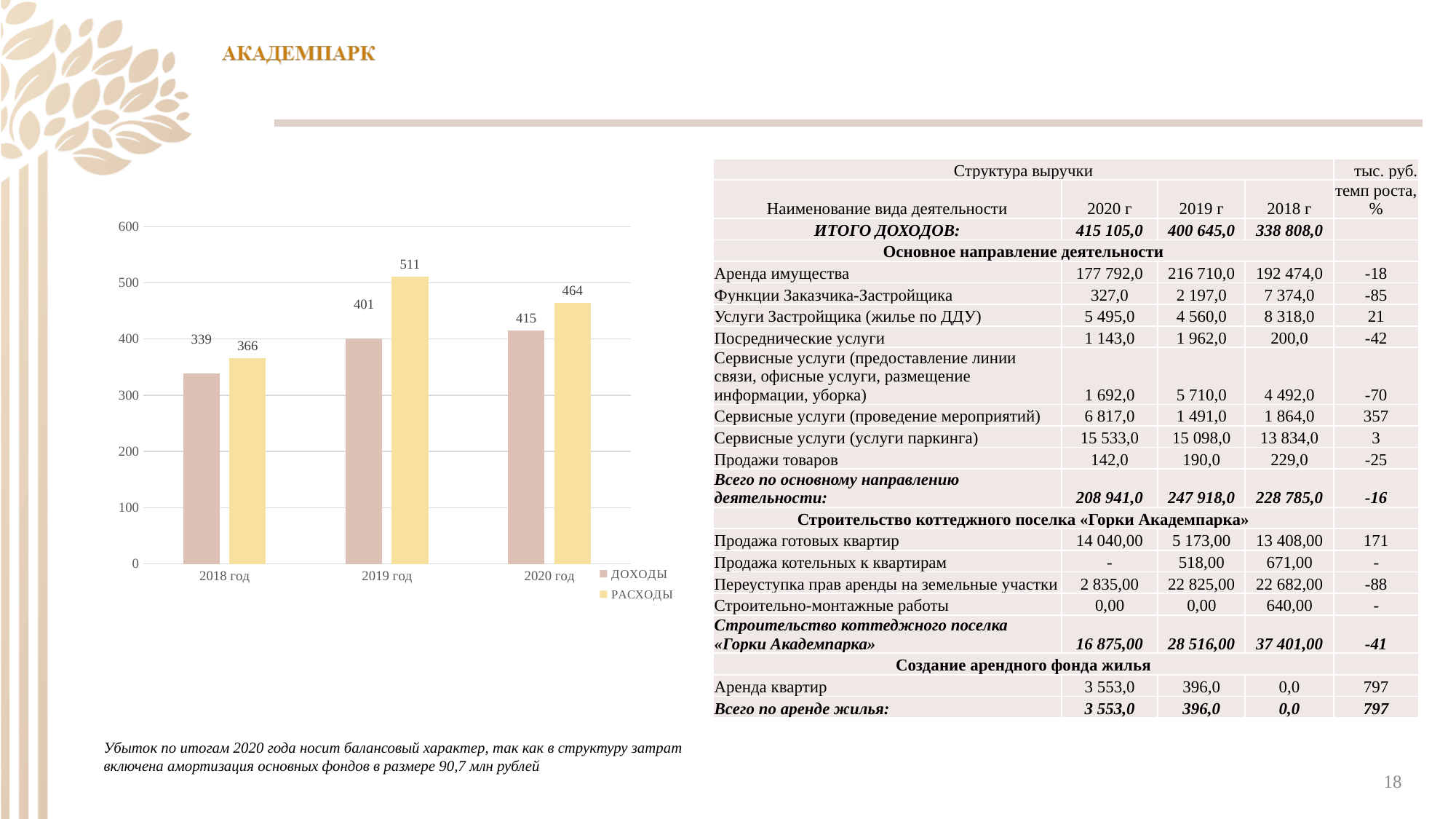
Which series is shown in yellow in the chart? РАСХОДЫ In which year is РАСХОДЫ the highest? 2019 год Do the ДОХОДЫ values rise or fall from 2018 год to 2020 год? rise How many year categories are shown on the x axis of the chart? 3 Which is larger in 2020 год, ДОХОДЫ or РАСХОДЫ? РАСХОДЫ In which year is ДОХОДЫ the lowest? 2018 год How many series does the chart legend list? 2 What type of chart is shown on the slide? bar chart What is the difference between РАСХОДЫ and ДОХОДЫ in 2019 год? 110 What is the value of ДОХОДЫ for 2018 год? 339 What is the value of РАСХОДЫ for 2019 год? 511 What is the value of ДОХОДЫ for 2020 год? 415